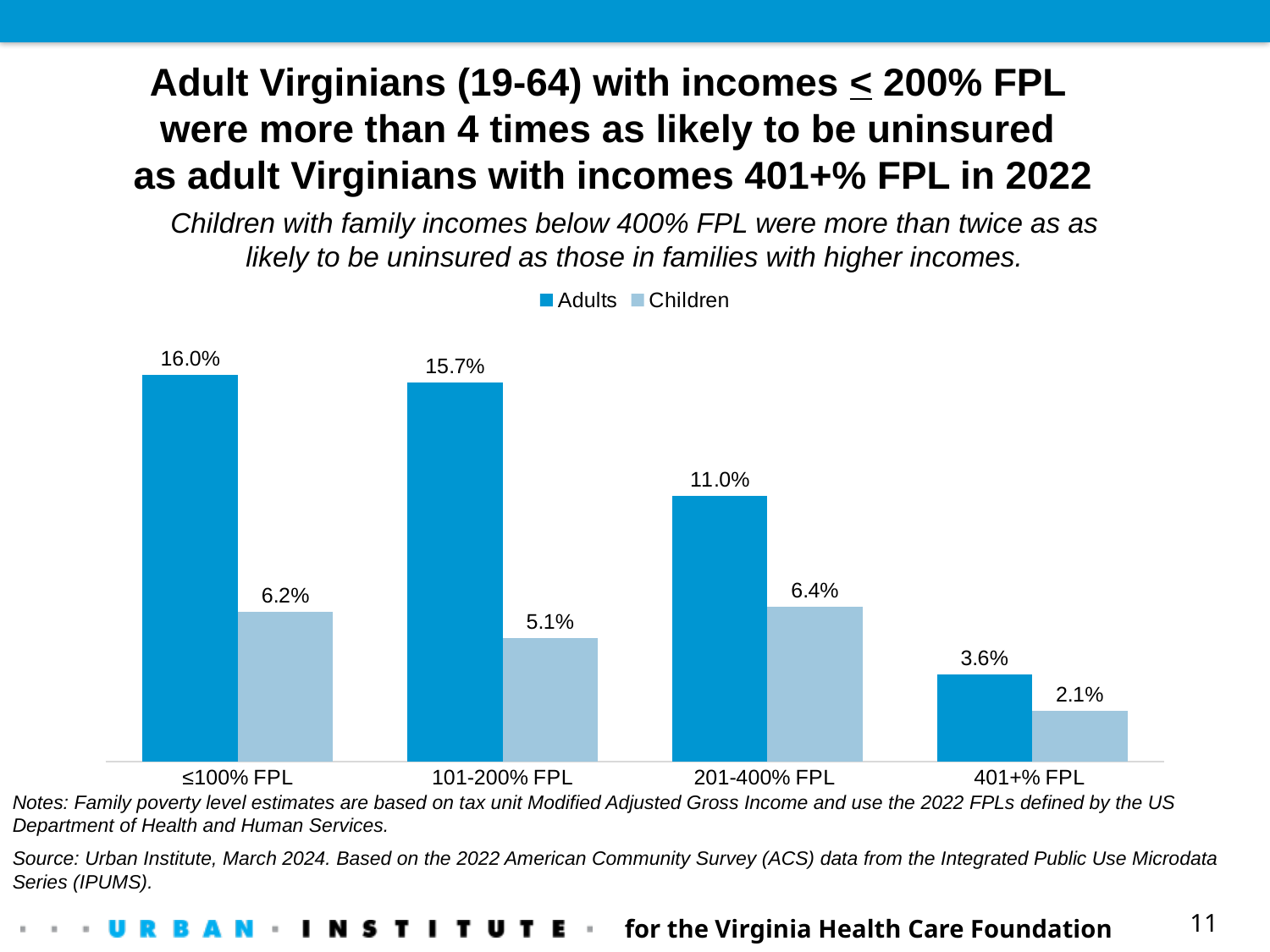
Which series is shown in the darker blue colour? Adults Which is larger: the Children value for ≤100% FPL or the Children value for 201-400% FPL? 201-400% FPL Do the Adults values rise or fall as income category increases along the x axis? Fall How many series does the legend list? 2 What is the uninsured rate for Children in the 201-400% FPL category? 6.4% What is the value for Children in the 401+% FPL category? 2.1% Which income category has the lowest uninsured rate for Children? 401+% FPL How many income categories are shown on the x axis? 4 Which income category has the highest uninsured rate for Adults? ≤100% FPL What kind of chart is shown on the slide? Bar chart What is the uninsured rate for Adults with incomes ≤100% FPL? 16.0% What is the difference between the Adults and Children values in the 101-200% FPL category? 10.6 percentage points